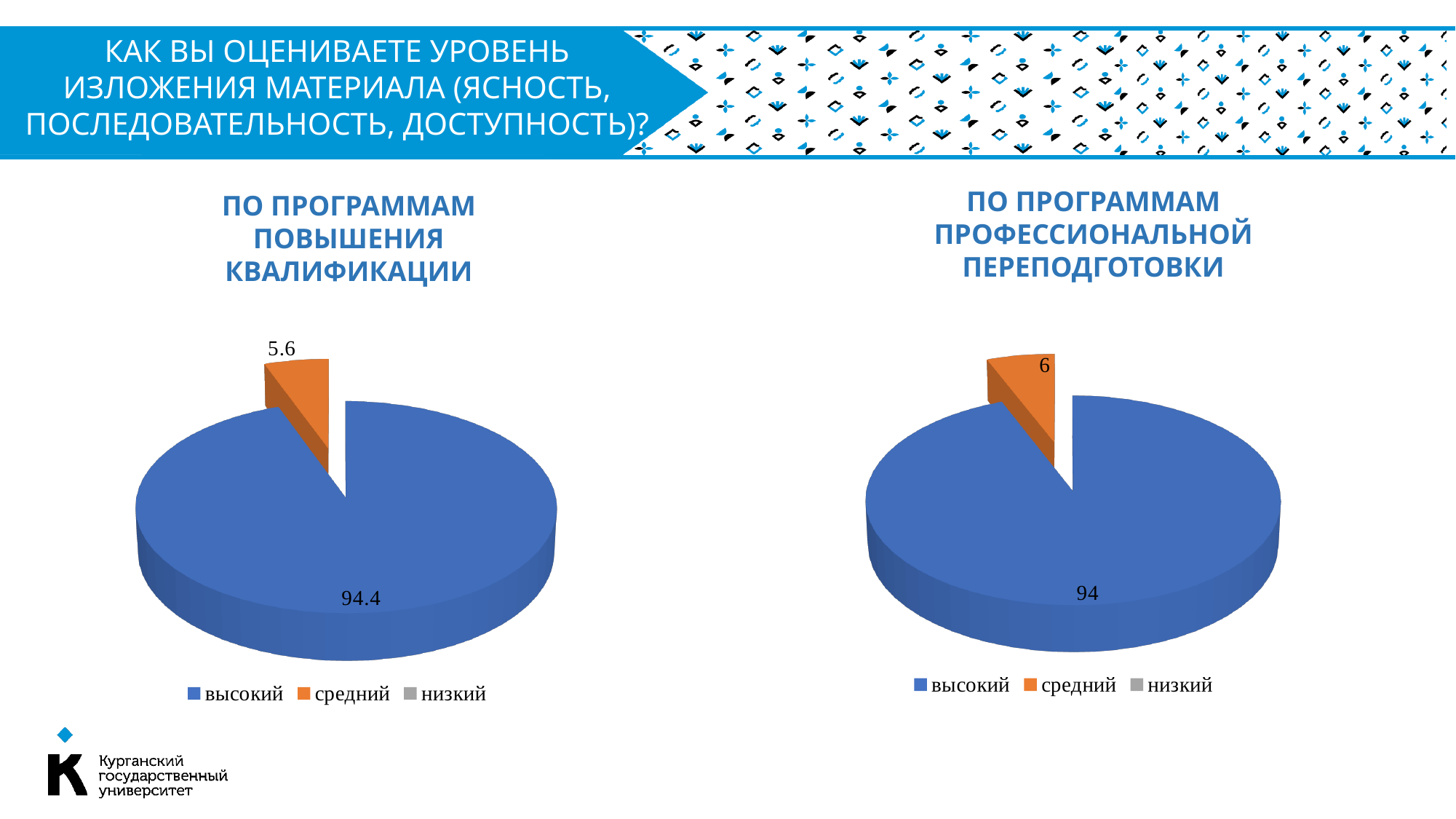
How many entries does the legend of the right chart list? 3 In the left chart, what colour is the «средний» slice? orange In the chart titled «ПО ПРОГРАММАМ ПОВЫШЕНИЯ КВАЛИФИКАЦИИ», what is the value for «средний»? 5.6 In the chart titled «ПО ПРОГРАММАМ ПРОФЕССИОНАЛЬНОЙ ПЕРЕПОДГОТОВКИ», what is the value for «средний»? 6 Which is larger: the «средний» value in the left chart or the «средний» value in the right chart? the right chart (6) In the right chart, which labelled category has the smallest slice? средний In the chart titled «ПО ПРОГРАММАМ ПРОФЕССИОНАЛЬНОЙ ПЕРЕПОДГОТОВКИ», what is the value for «высокий»? 94 What type of chart is used on the left side of the slide? pie chart In the chart titled «ПО ПРОГРАММАМ ПОВЫШЕНИЯ КВАЛИФИКАЦИИ», what is the value for «высокий»? 94.4 In the left chart, what is the difference between the values for «высокий» and «средний»? 88.8 In the right chart, what is the difference between the values for «высокий» and «средний»? 88 In the left chart, which category has the largest slice? высокий